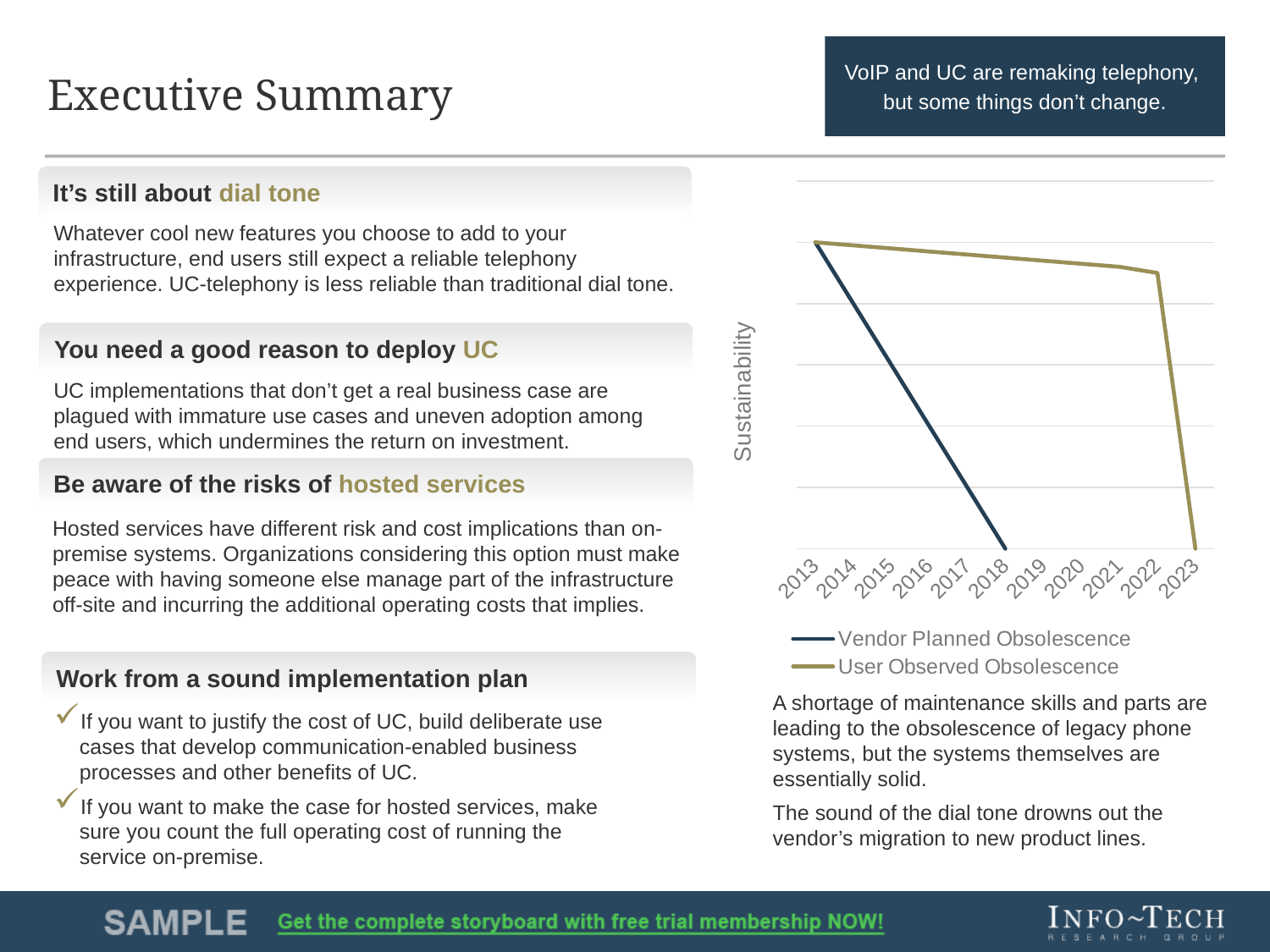
How many series does the chart's legend list? 2 What kind of chart is shown on the slide? line chart In 2016, which series has the higher value: Vendor Planned Obsolescence or User Observed Obsolescence? User Observed Obsolescence How many years are labelled along the x axis of the chart? 11 Which series reaches the bottom of the chart first? Vendor Planned Obsolescence Does the Vendor Planned Obsolescence line rise or fall from 2013 onward? fall Around which year does the User Observed Obsolescence line reach the bottom of the chart? 2023 Which series declines more steeply between 2013 and 2018? Vendor Planned Obsolescence What is the first year shown on the chart's x axis? 2013 Around which year does the Vendor Planned Obsolescence line reach the bottom of the chart? 2018 What is the last year shown on the chart's x axis? 2023 Does the User Observed Obsolescence line rise or fall across the years shown? fall